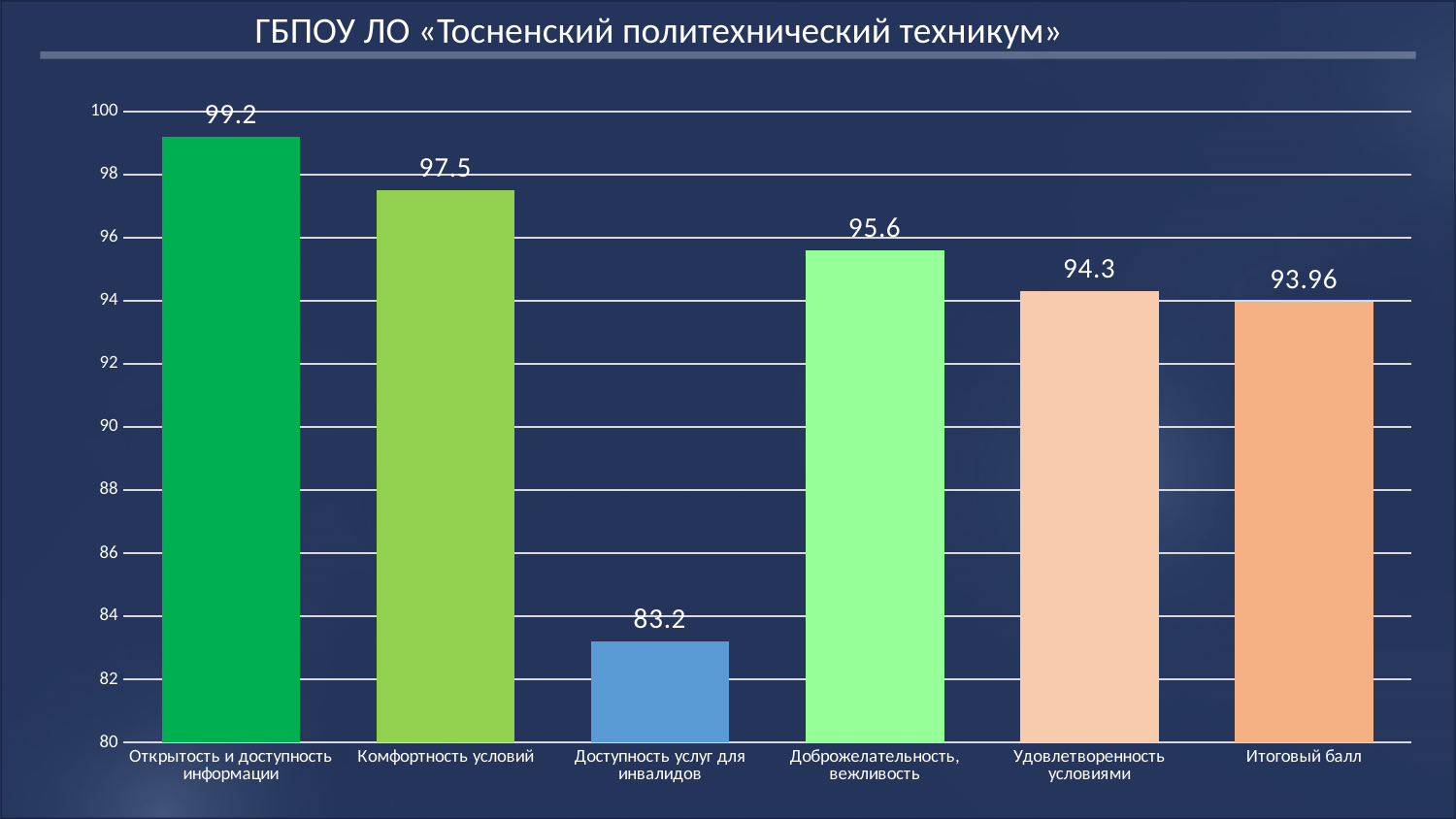
Which is larger: «Удовлетворенность условиями» or «Доброжелательность, вежливость»? Доброжелательность, вежливость Is the value for «Доступность услуг для инвалидов» greater or less than 90? less What is the value for «Доступность услуг для инвалидов»? 83.2 How many categories are shown on the chart? 6 What is the difference between «Комфортность условий» and «Доброжелательность, вежливость»? 1.9 What colour is the bar for «Доступность услуг для инвалидов»? blue What is the value for «Итоговый балл»? 93.96 What kind of chart is shown on the slide? bar chart Which category has the lowest value? Доступность услуг для инвалидов What is the title of the slide? ГБПОУ ЛО «Тосненский политехнический техникум» Which category has the highest value? Открытость и доступность информации What is the value for «Открытость и доступность информации»? 99.2